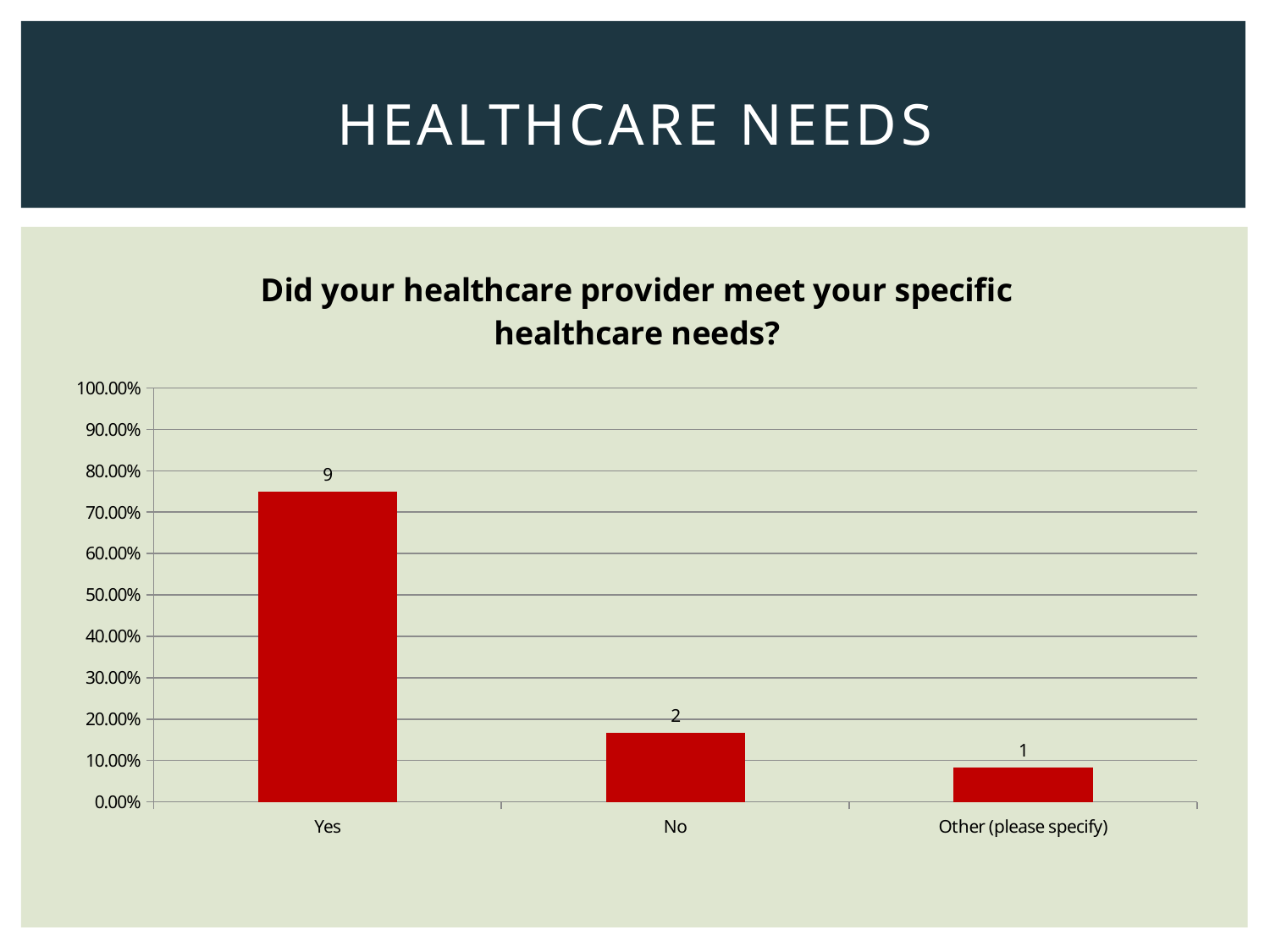
Which category has the shortest bar? Other (please specify) What type of chart is shown on the slide? Bar chart Which bar is taller, No or Other (please specify)? No Is the value for Yes greater or less than 70.00%? greater What data label is shown above the No bar? 2 Which category has the tallest bar? Yes Is the value for No greater or less than 20.00%? less How many categories are shown on the x axis? 3 What data label is shown above the Yes bar? 9 What is the difference between the data labels for Yes and No? 7 What data label is shown above the Other (please specify) bar? 1 Is the value for Other (please specify) greater or less than 10.00%? less